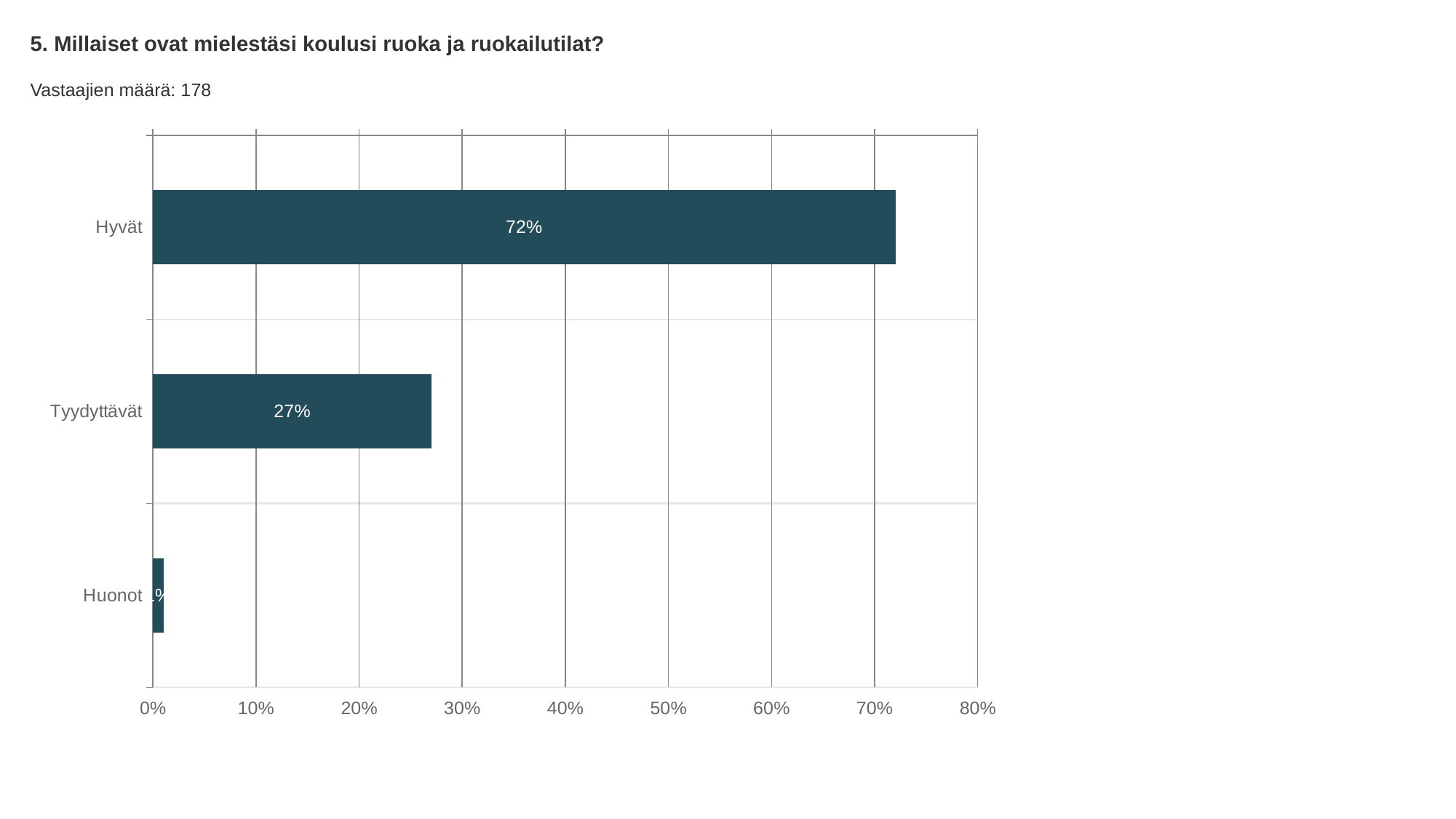
Which category has the highest value? Hyvät Which is larger, the value for "Tyydyttävät" or the value for "Huonot"? Tyydyttävät What percentage of respondents answered "Tyydyttävät"? 27% What kind of chart is shown on the slide? bar chart Is the value for "Hyvät" greater or less than 70%? greater How many categories are shown in the chart? 3 What is the highest value shown on the horizontal axis? 80% How many respondents (Vastaajien määrä) are reported on the slide? 178 What is the difference between the values for "Hyvät" and "Tyydyttävät"? 45% Is the value for "Huonot" greater or less than 10%? less What percentage of respondents answered "Hyvät"? 72% Which category has the lowest value? Huonot